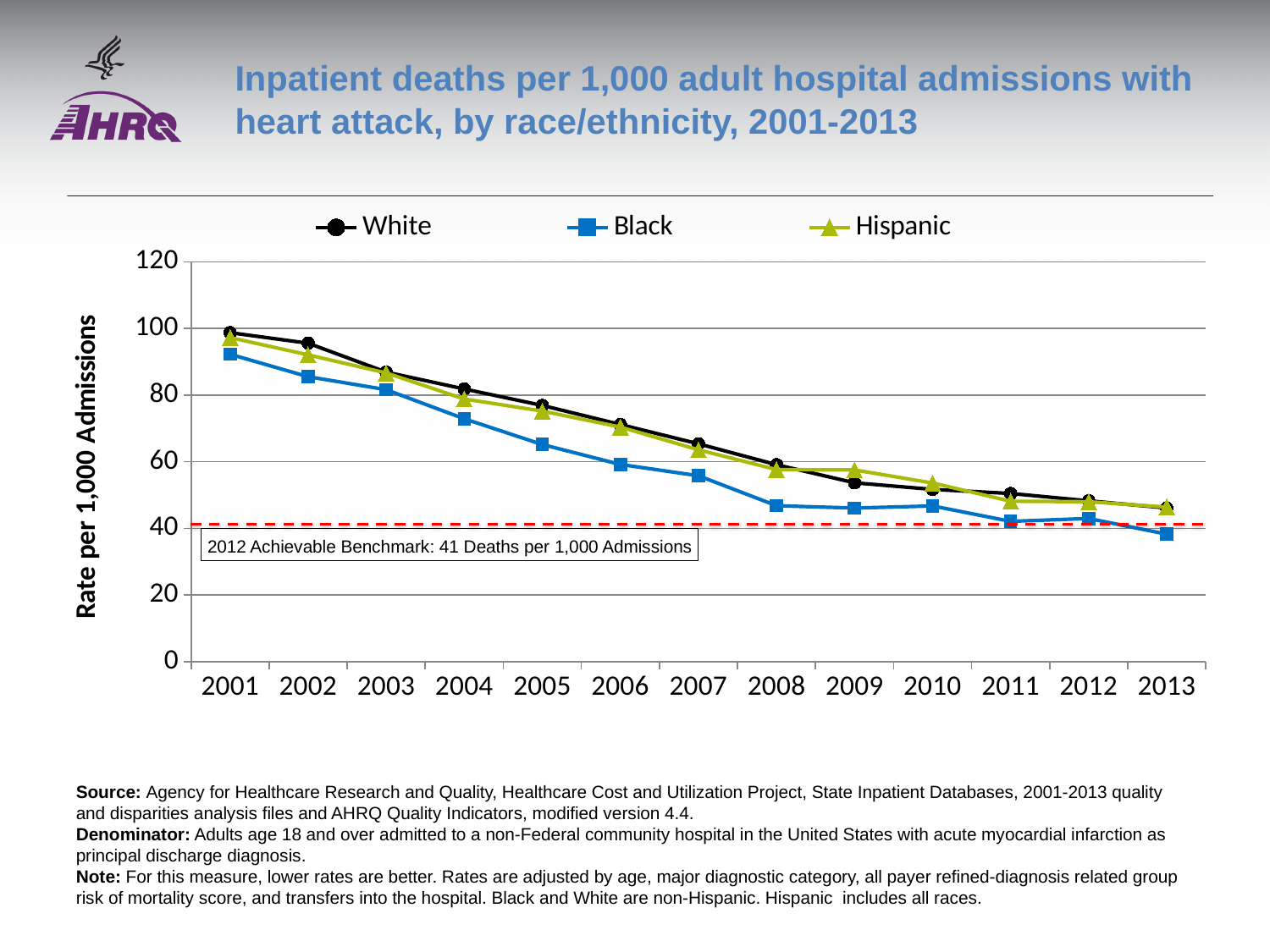
Which series has the lowest value in 2005? Black Is the value for White in 2006 greater or less than 60? greater Is the value for Hispanic in 2013 greater or less than 60? less Is the value for Black in 2008 greater or less than 60? less How many years are shown along the x axis? 13 What kind of chart is shown on the slide? line chart In 2004, which series has the larger value, White or Black? White What is the 2012 achievable benchmark shown on the chart? 41 Deaths per 1,000 Admissions In which year is the White series at its highest? 2001 How many series does the legend list? 3 Do the rates for the White series rise or fall from 2001 to 2013? fall